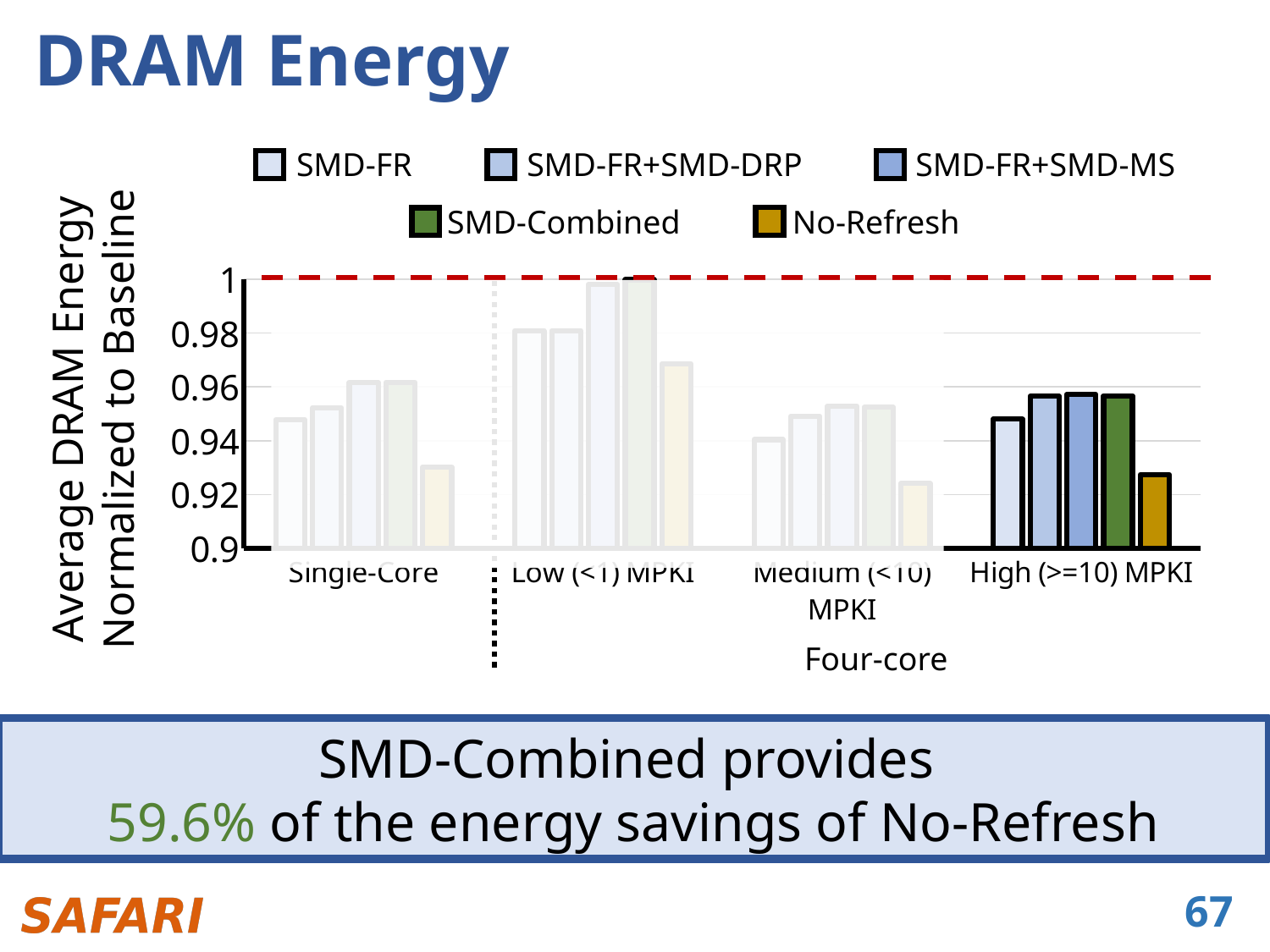
At what y-axis value is the red dashed horizontal line drawn? 1 In the High (>=10) MPKI group, is the value for No-Refresh greater or less than 0.94? less In the Single-Core group, is the value for No-Refresh greater or less than 0.94? less In the High (>=10) MPKI group, which is larger: SMD-FR or No-Refresh? SMD-FR How many series does the legend list? 5 What is the y-axis title of the chart? Average DRAM Energy Normalized to Baseline In the Low (<1) MPKI group, is the value for SMD-FR+SMD-MS greater or less than 0.98? greater In the High (>=10) MPKI group, which series has the lowest value? No-Refresh What kind of chart is shown on the slide? bar chart For the SMD-Combined series, which category has the highest value? Low (<1) MPKI How many categories are shown along the x axis? 4